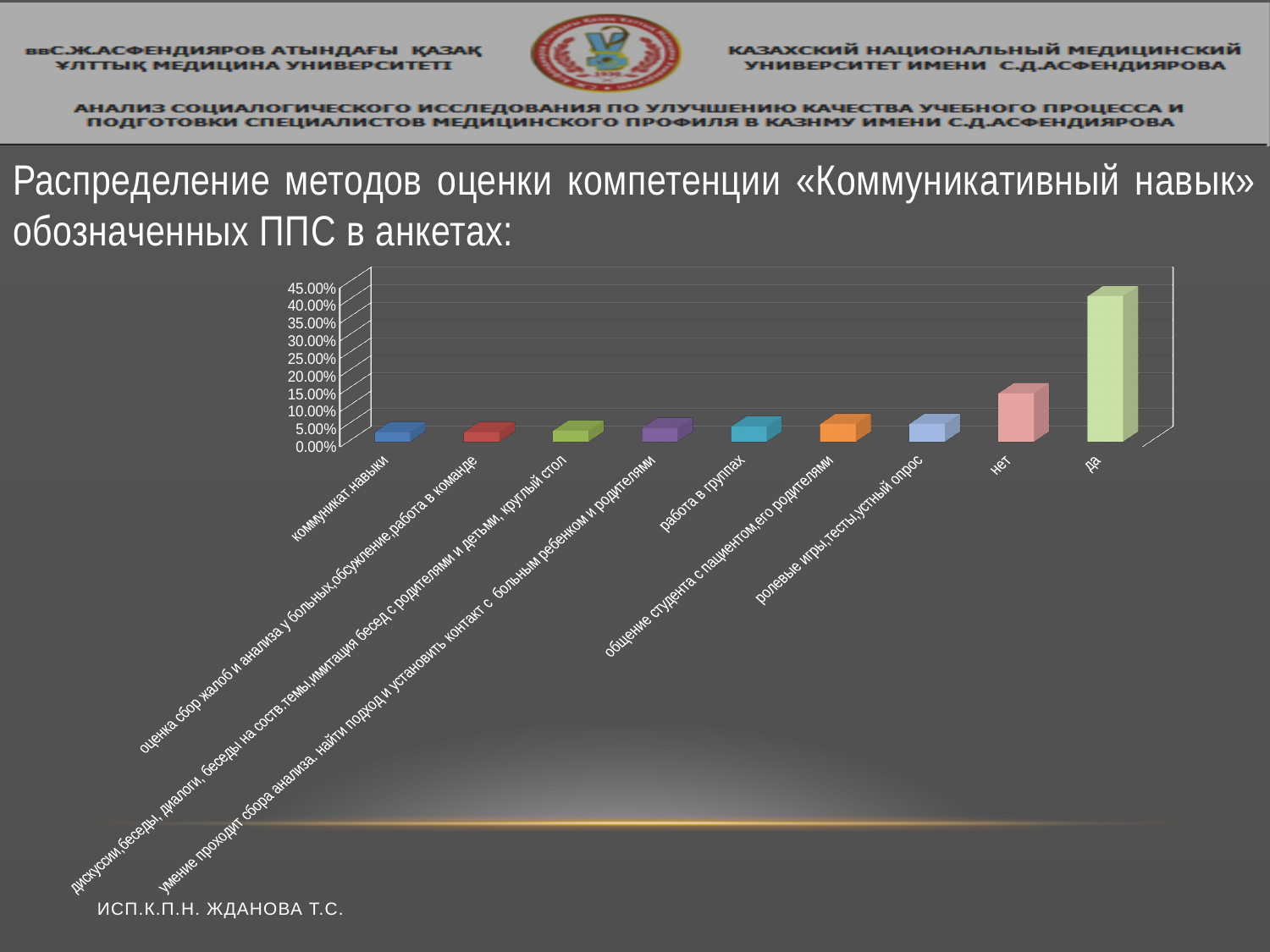
What kind of chart is shown on the slide? bar chart How many categories are plotted on the x axis of the chart? 9 Which category is plotted last (rightmost) on the x axis? да Which is larger, the value for "да" or the value for "нет"? да Is the value for "нет" greater or less than 25.00%? less Is the value for "нет" greater or less than 10.00%? greater Is the value for "да" greater or less than 30.00%? greater What is the highest value shown on the vertical axis of the chart? 45.00% Which category has the highest value in the chart? да Which is larger, the value for "нет" or the value for "ролевые игры,тесты,устный опрос"? нет